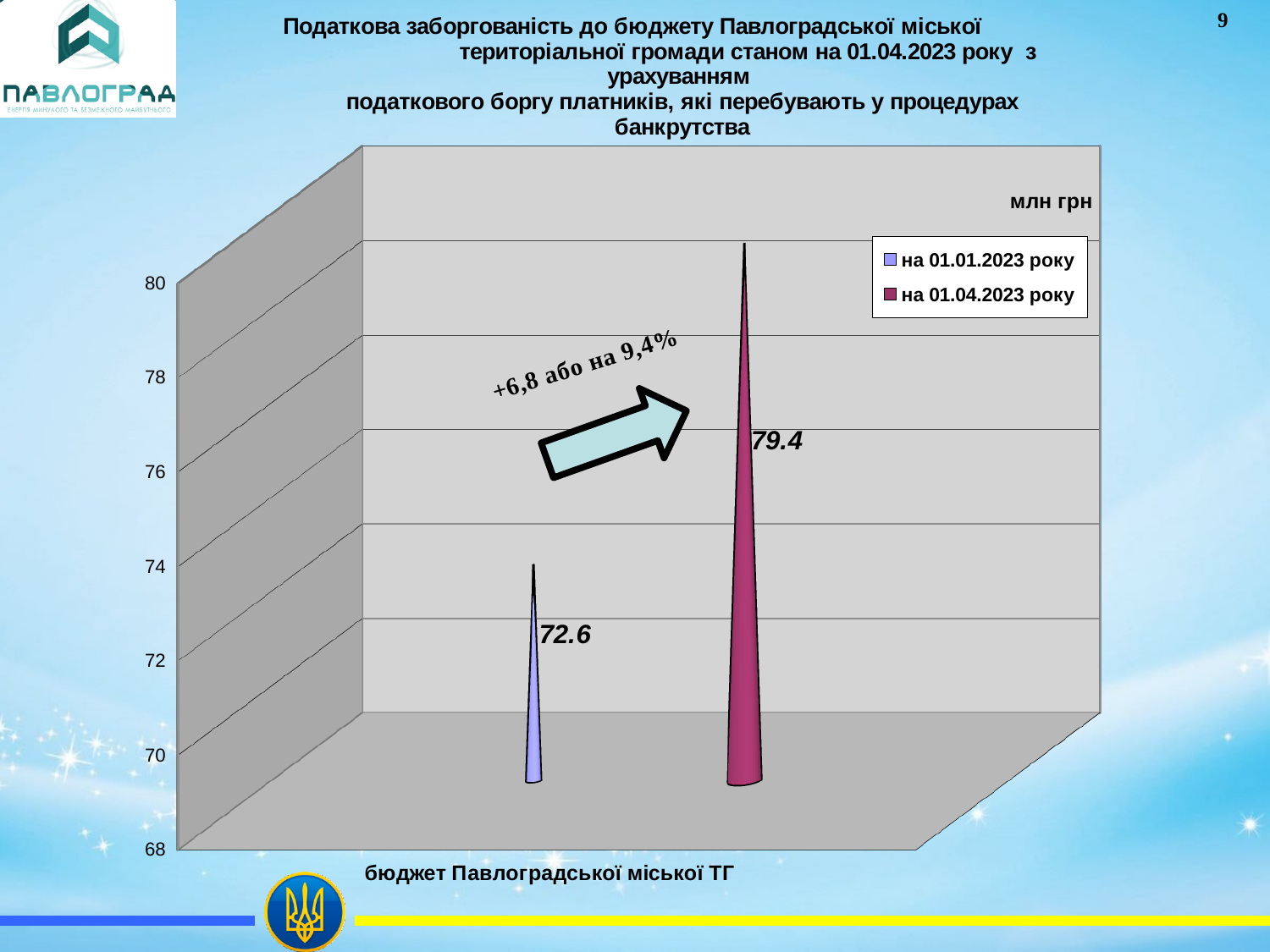
How many categories are shown on the x axis? 1 What is the value for the series "на 01.04.2023 року"? 79.4 What is the value for the series "на 01.01.2023 року"? 72.6 Is the value for "на 01.04.2023 року" greater or less than 78? greater Which series has the higher value, "на 01.01.2023 року" or "на 01.04.2023 року"? на 01.04.2023 року Which series shows the lowest value on the chart? на 01.01.2023 року How many series does the legend list? 2 Which series shows the highest value on the chart? на 01.04.2023 року What kind of chart is shown on the slide? bar chart What unit of measurement is indicated on the chart? млн грн Is the value for "на 01.01.2023 року" greater or less than 74? less What is the difference between the value for "на 01.04.2023 року" and the value for "на 01.01.2023 року"? 6.8